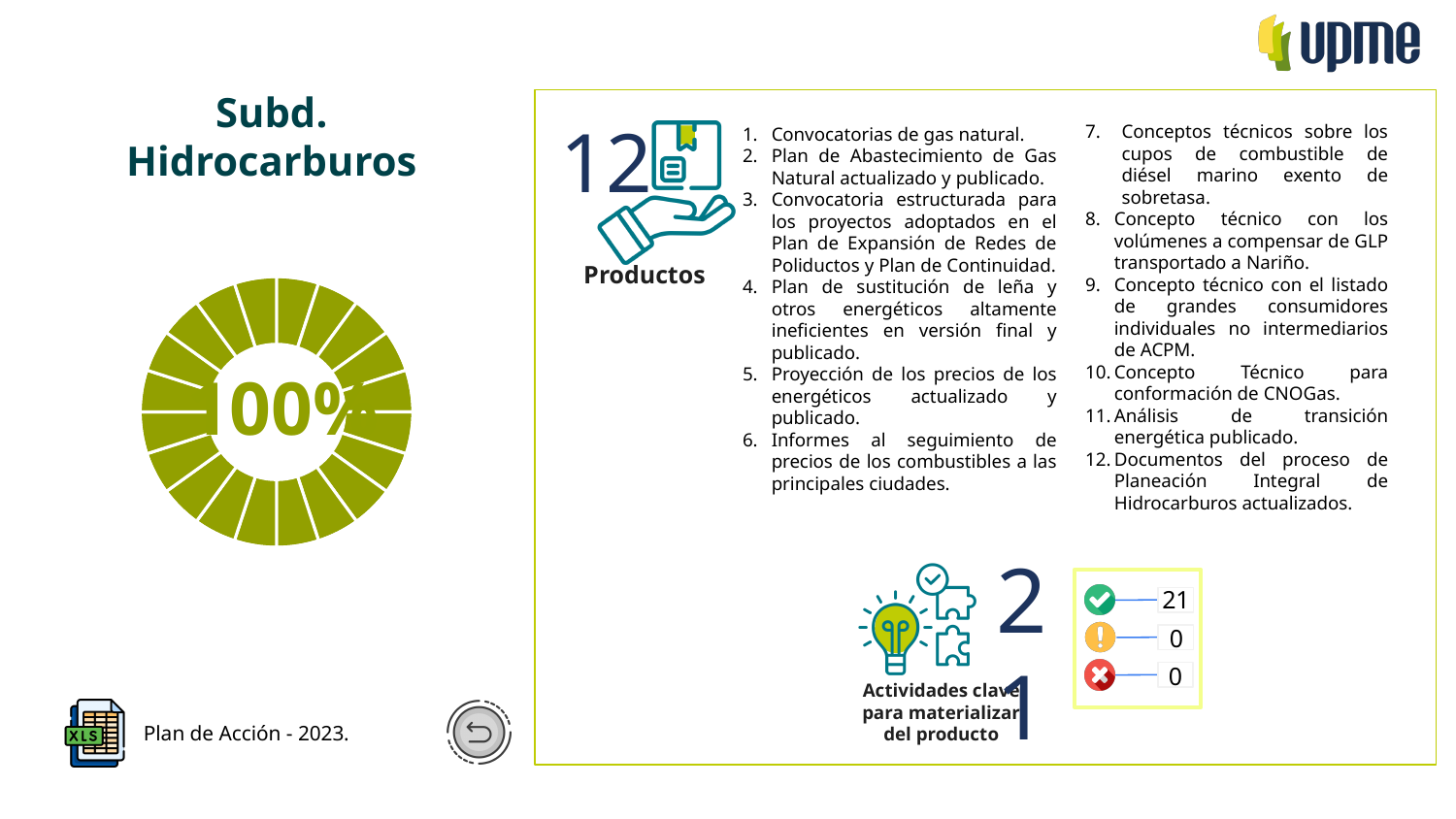
Does the ring-shaped chart on the left of the slide use more than one colour for its segments? No In the status indicator at the bottom right of the slide, is the green check value larger than the yellow warning value? Yes How many status rows are shown in the indicator at the bottom right of the slide? 3 In the status indicator at the bottom right of the slide, what is the difference between the green check value and the red cross value? 21 In the status indicator at the bottom right of the slide, what number is shown next to the red cross icon? 0 In the status indicator at the bottom right of the slide, what number is shown next to the yellow warning icon? 0 In the status indicator at the bottom right of the slide, which icon has the highest number? green check In the status indicator at the bottom right of the slide, what number is shown next to the green check icon? 21 What colour are the segments of the ring-shaped chart on the left of the slide? olive green What kind of chart is shown on the left side of the slide under the heading 'Subd. Hidrocarburos'? doughnut chart